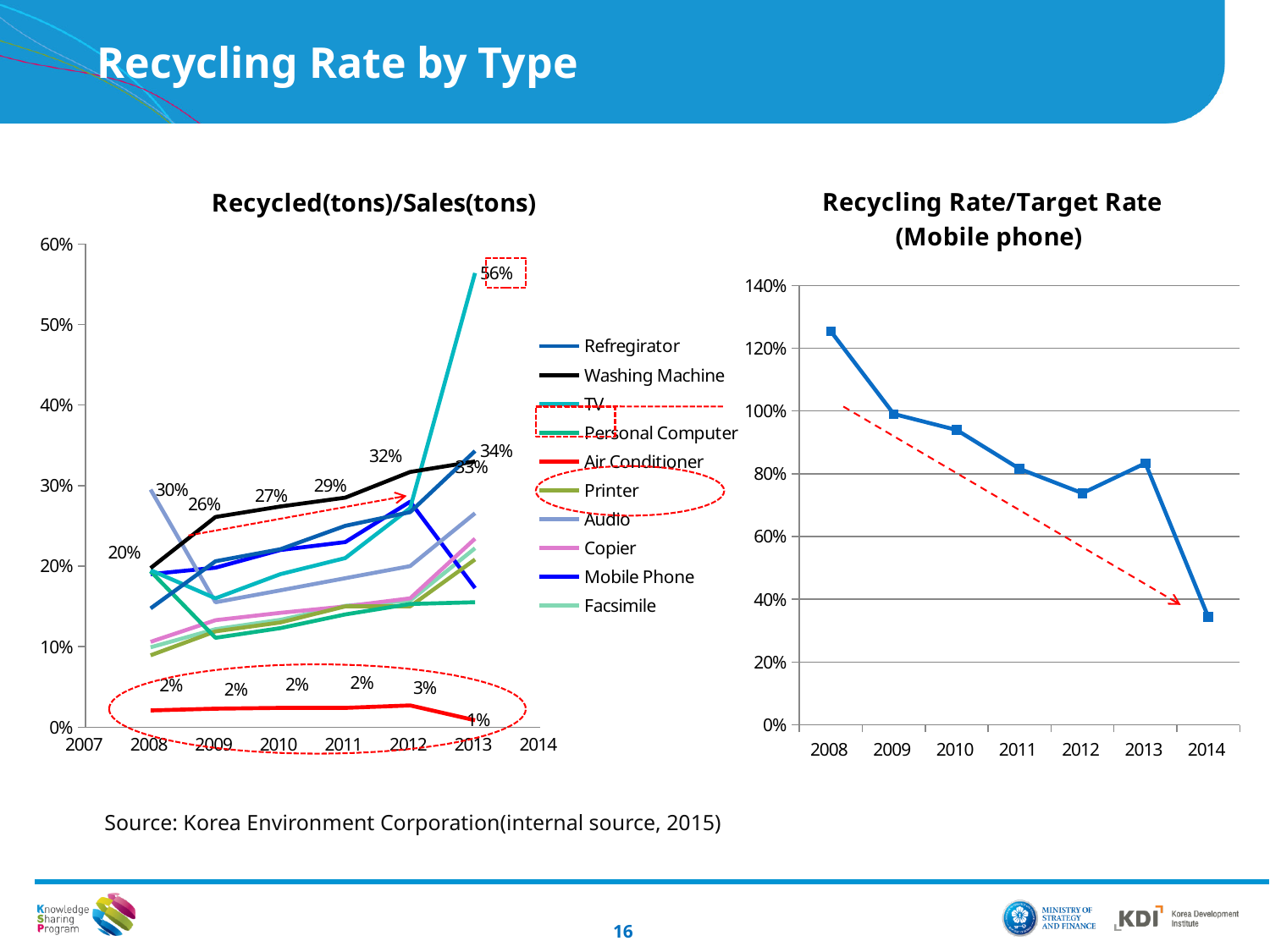
In the 'Recycled(tons)/Sales(tons)' chart, which series has the highest value in 2013? TV In the 'Recycling Rate/Target Rate (Mobile phone)' chart, how many data points are plotted? 7 In the 'Recycled(tons)/Sales(tons)' chart, what is the value for TV in 2013? 56% In the 'Recycling Rate/Target Rate (Mobile phone)' chart, is the value for 2008 greater or less than 120%? greater What kind of chart is the 'Recycled(tons)/Sales(tons)' chart? Line chart In the 'Recycled(tons)/Sales(tons)' chart, what is the value for Air Conditioner in 2013? 1% In the 'Recycling Rate/Target Rate (Mobile phone)' chart, which year has the lowest value? 2014 In the 'Recycled(tons)/Sales(tons)' chart, by how many percentage points did Washing Machine rise from 2008 (20%) to 2013 (33%)? 13 percentage points How many series does the legend of the 'Recycled(tons)/Sales(tons)' chart list? 10 In the 'Recycling Rate/Target Rate (Mobile phone)' chart, which year has the highest value? 2008 In the 'Recycled(tons)/Sales(tons)' chart, which is larger in 2013: TV or Refregirator? TV In the 'Recycled(tons)/Sales(tons)' chart, what is the value for Washing Machine in 2012? 32%